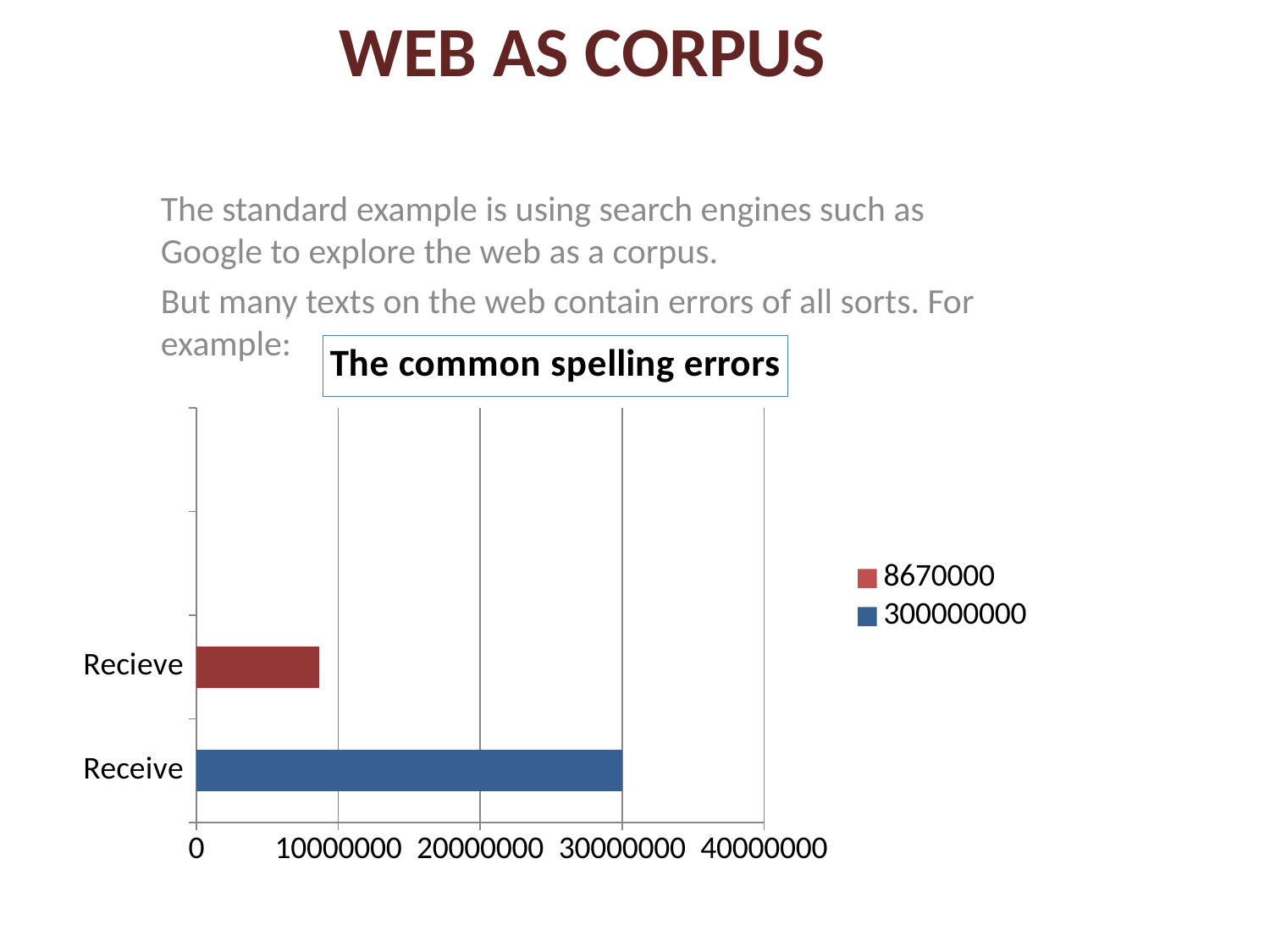
Which category has the shortest bar in the chart? Recieve What colour is the bar for Recieve? red Which category has the longest bar in the chart? Receive What is the highest value shown on the chart's horizontal axis? 40000000 Is the bar for Recieve greater or less than 10000000? less What is the title of the chart? The common spelling errors What kind of chart is shown on the slide? bar chart How many entries does the chart's legend list? 2 How many categories are shown on the chart's vertical axis? 2 Which is larger, the bar for Receive or the bar for Recieve? Receive Is the bar for Receive greater or less than 20000000? greater